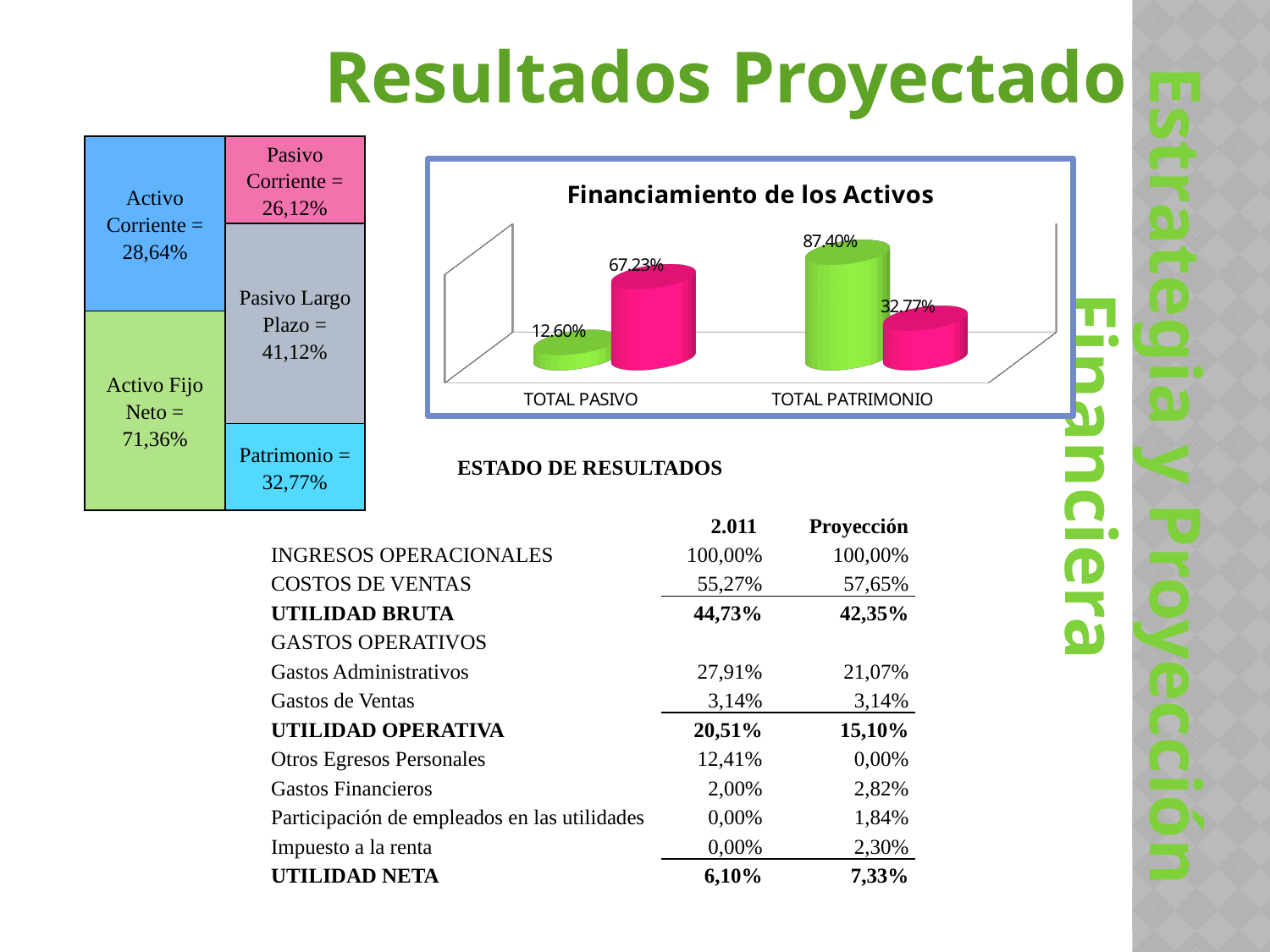
In the "Financiamiento de los Activos" chart, what is the value of the pink bar for TOTAL PATRIMONIO? 32.77% How many categories are shown on the x axis of the "Financiamiento de los Activos" chart? 2 In the "Financiamiento de los Activos" chart, which is larger for TOTAL PASIVO: the green bar or the pink bar? pink bar In the "Financiamiento de los Activos" chart, what is the value of the green bar for TOTAL PATRIMONIO? 87.40% In the "Financiamiento de los Activos" chart, what is the value of the green bar for TOTAL PASIVO? 12.60% In the "Financiamiento de los Activos" chart, which bar has the lowest value? green bar for TOTAL PASIVO In the "Financiamiento de los Activos" chart, what is the value of the pink bar for TOTAL PASIVO? 67.23% What is the title of the chart on the slide? Financiamiento de los Activos What kind of chart is "Financiamiento de los Activos"? bar chart In the "Financiamiento de los Activos" chart, what is the difference between the green bar for TOTAL PATRIMONIO and the green bar for TOTAL PASIVO? 74.80% In the "Financiamiento de los Activos" chart, which bar has the highest value? green bar for TOTAL PATRIMONIO In the "Financiamiento de los Activos" chart, what is the difference between the pink bar for TOTAL PASIVO and the pink bar for TOTAL PATRIMONIO? 34.46%